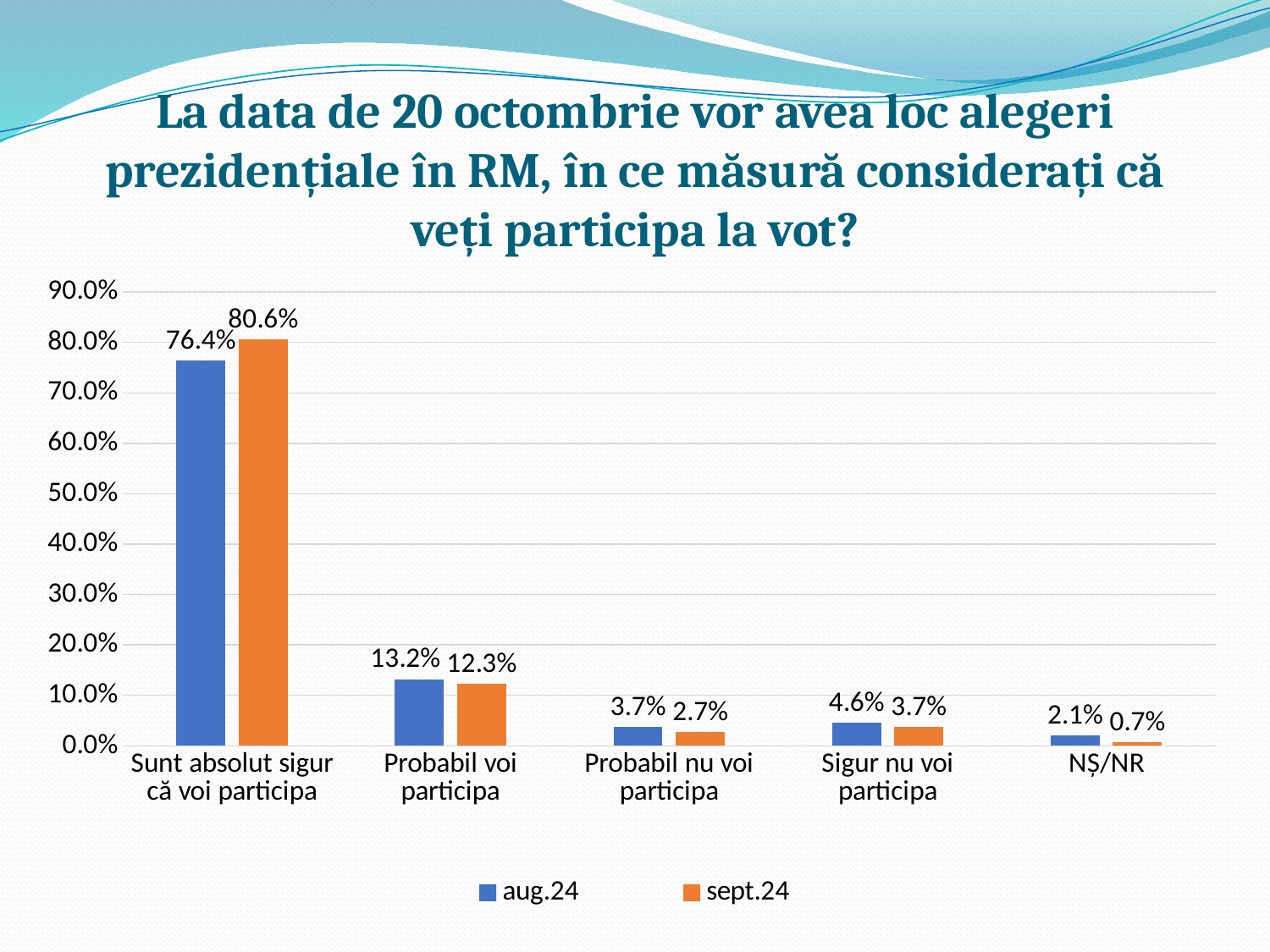
How many series does the legend list? 2 What kind of chart is shown on the slide? bar chart What is the value for "NȘ/NR" in the sept.24 series? 0.7% Which category has the highest value in the aug.24 series? Sunt absolut sigur că voi participa Which is larger for "Sigur nu voi participa": the aug.24 value or the sept.24 value? aug.24 What is the value for "Probabil voi participa" in the aug.24 series? 13.2% How many categories are shown on the x axis? 5 What is the value for "Sunt absolut sigur că voi participa" in the sept.24 series? 80.6% Is the aug.24 value for "Sunt absolut sigur că voi participa" greater or less than 70.0%? greater What is the difference between the sept.24 and aug.24 values for "Sunt absolut sigur că voi participa"? 4.2% Which category has the lowest value in the sept.24 series? NȘ/NR Which series is shown in orange? sept.24